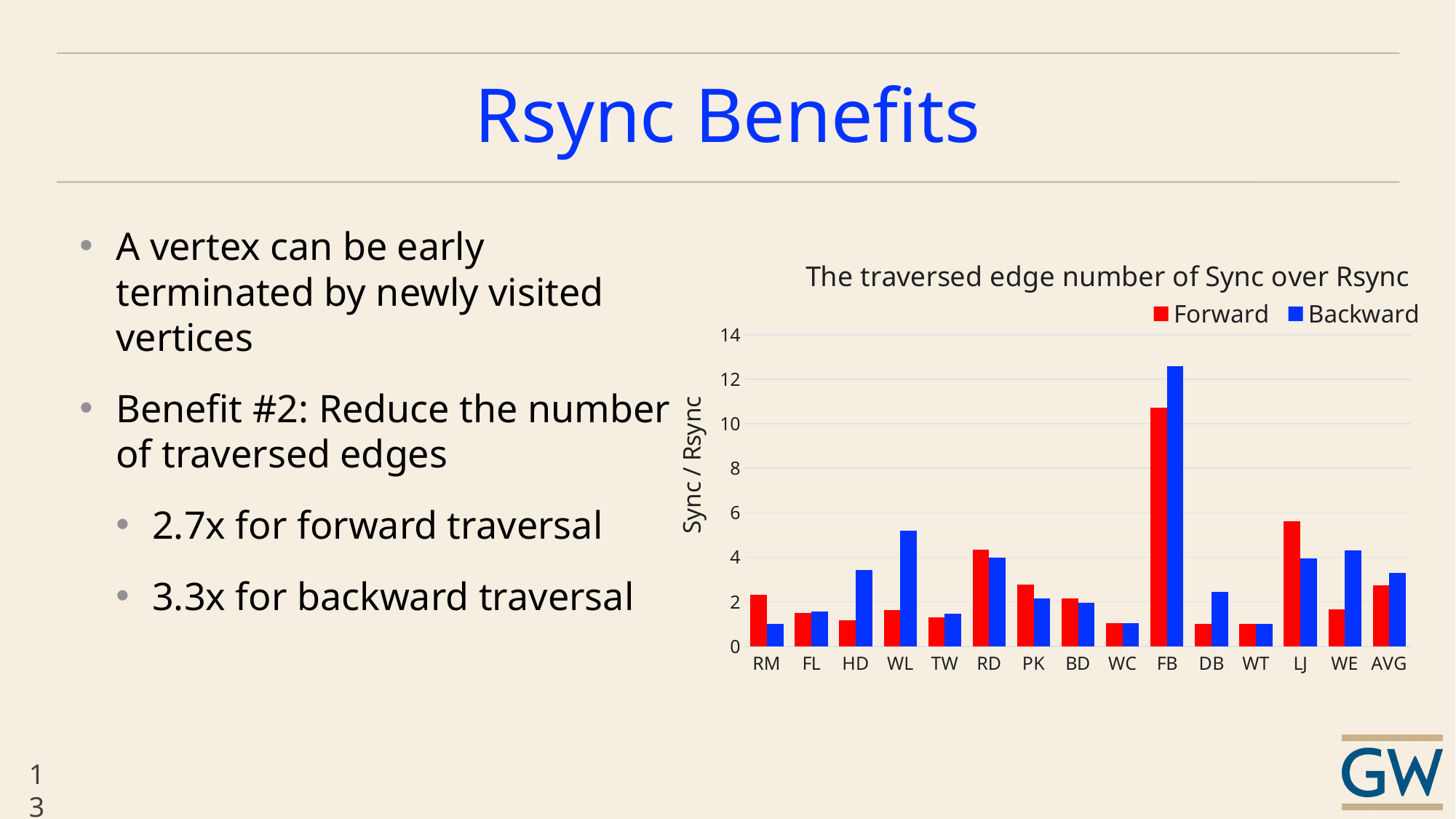
How many categories are shown along the x axis of the chart? 15 Is the Backward value for FB greater or less than 12? greater Is the Forward value for AVG greater or less than 4? less For HD, which is larger: the Forward value or the Backward value? Backward What is the title of the chart? The traversed edge number of Sync over Rsync How many series does the chart legend list? 2 Is the Forward value for FB greater or less than 10? greater What kind of chart is shown on the slide? bar chart For LJ, which is larger: the Forward value or the Backward value? Forward Which category has the highest Backward value? FB Which category has the highest Forward value? FB